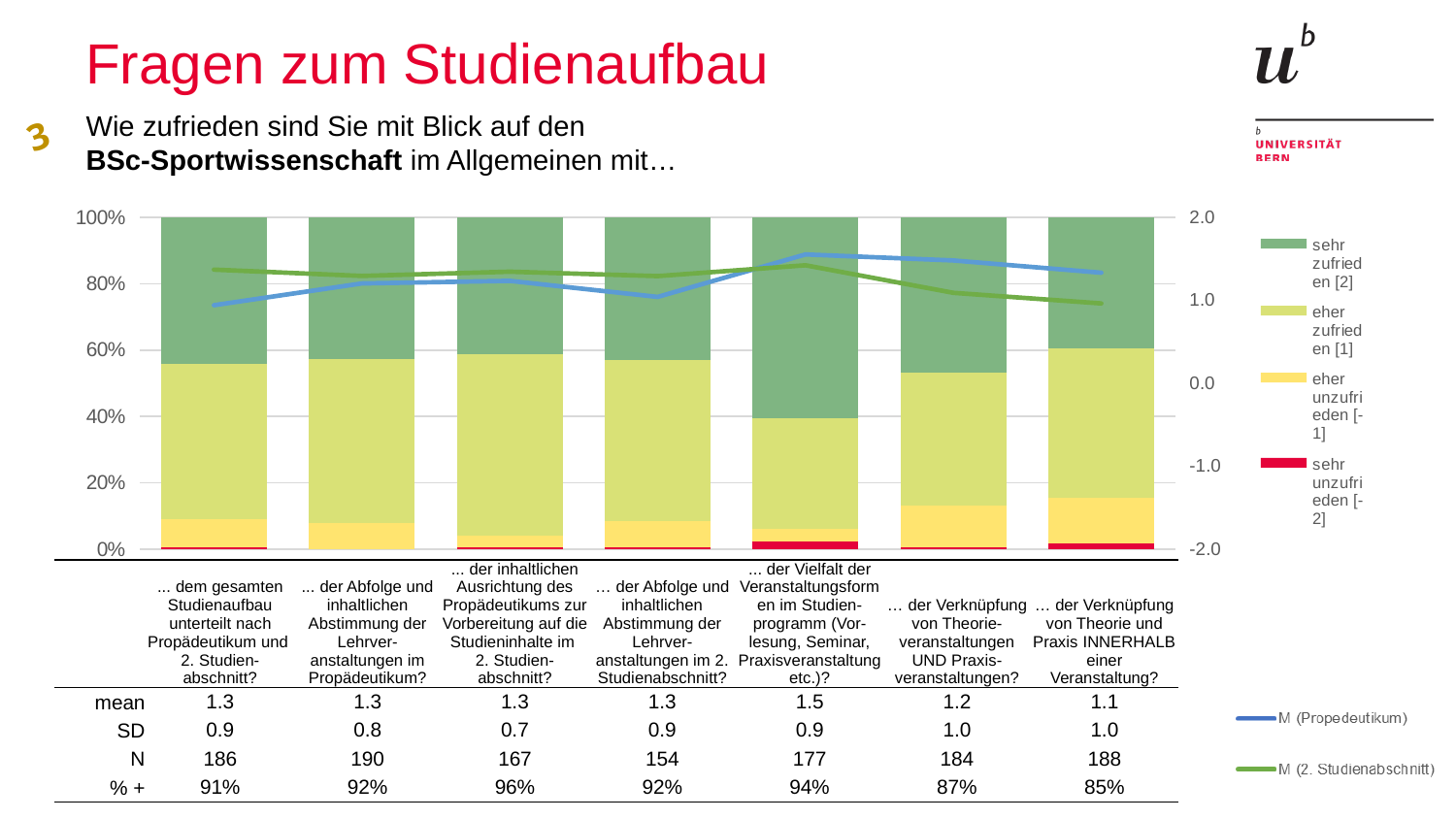
Which category has the lowest '% +' value in the table below the chart? ... der Verknüpfung von Theorie und Praxis INNERHALB einer Veranstaltung How many question categories are plotted along the x axis of the chart? 7 What kind of chart is shown on the slide? combination bar and line chart (stacked bars with two lines) What is the difference in '% +' between '... der inhaltlichen Ausrichtung des Propädeutikums' (96%) and '... der Verknüpfung von Theorie und Praxis INNERHALB einer Veranstaltung' (85%)? 11 percentage points Which category has the highest mean value in the table below the chart? ... der Vielfalt der Veranstaltungsformen im Studienprogramm In the bar for '... der Vielfalt der Veranstaltungsformen', is the 'sehr zufrieden [2]' segment greater or less than 40% of the bar? greater Which colour represents 'sehr unzufrieden [-2]' in the chart legend? red Which has the larger N: '... dem gesamten Studienaufbau unterteilt nach Propädeutikum und 2. Studienabschnitt' or '... der Verknüpfung von Theorie und Praxis INNERHALB einer Veranstaltung'? ... der Verknüpfung von Theorie und Praxis INNERHALB einer Veranstaltung What is the mean value shown for '... der Vielfalt der Veranstaltungsformen im Studienprogramm'? 1.5 What is the N value shown for '... der Abfolge und inhaltlichen Abstimmung der Lehrveranstaltungen im Propädeutikum'? 190 What is the '% +' value shown for '... der inhaltlichen Ausrichtung des Propädeutikums zur Vorbereitung auf die Studieninhalte im 2. Studienabschnitt'? 96% How many satisfaction levels does the colour legend on the right of the chart list? 4